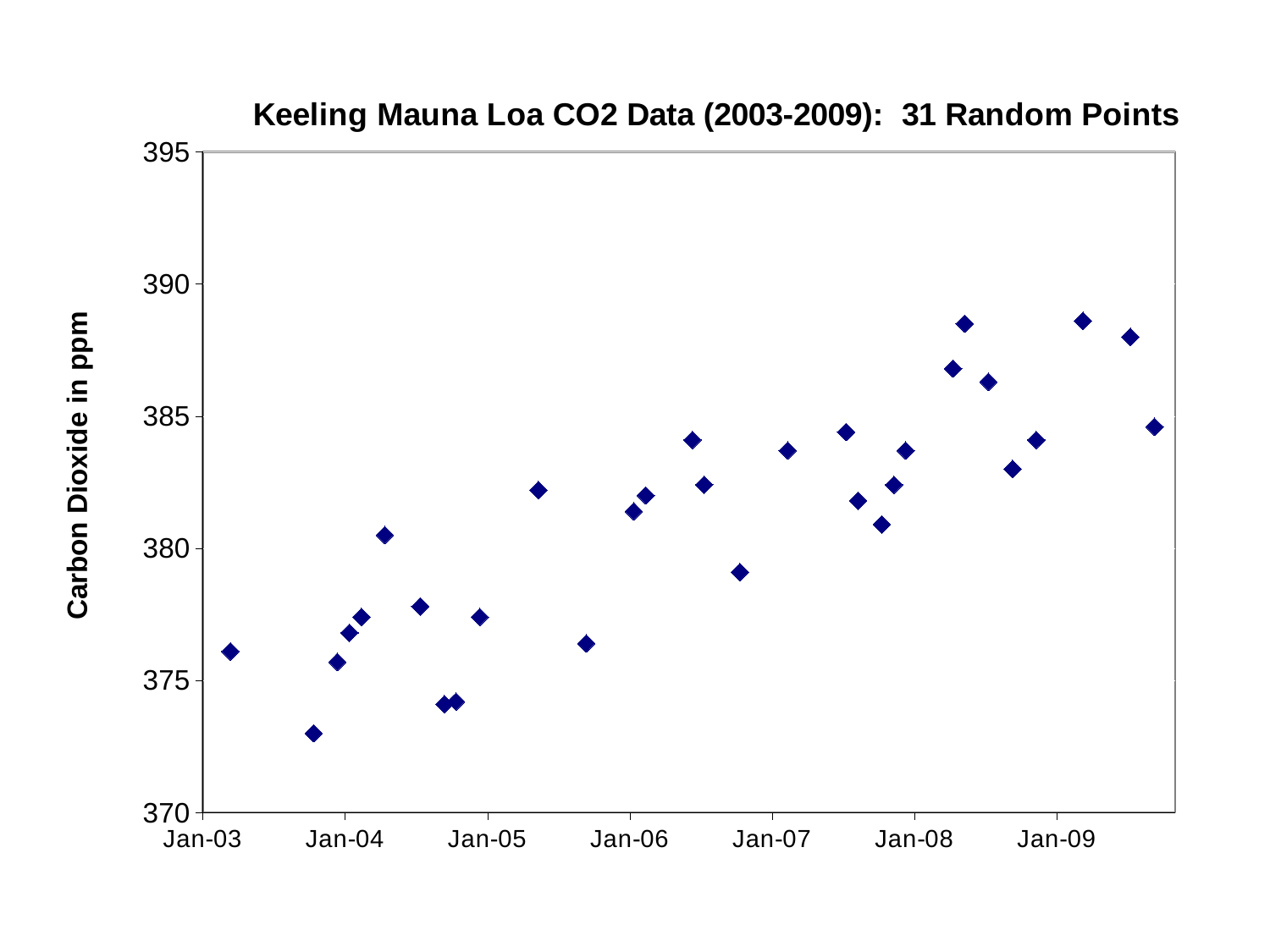
What kind of chart is shown on the slide? Scatter chart What is the title of the chart? Keeling Mauna Loa CO2 Data (2003-2009): 31 Random Points Which is larger, the earliest point near Jan-03 or the latest point after Jan-09? The latest point after Jan-09 Is the lowest plotted point greater or less than 370? greater Do the carbon dioxide values generally rise or fall from Jan-03 to Jan-09? Rise Is the highest plotted point greater or less than 390? less What is the label on the vertical axis? Carbon Dioxide in ppm How many data points are plotted on the chart? 31 Is the highest plotted point greater or less than 385? greater